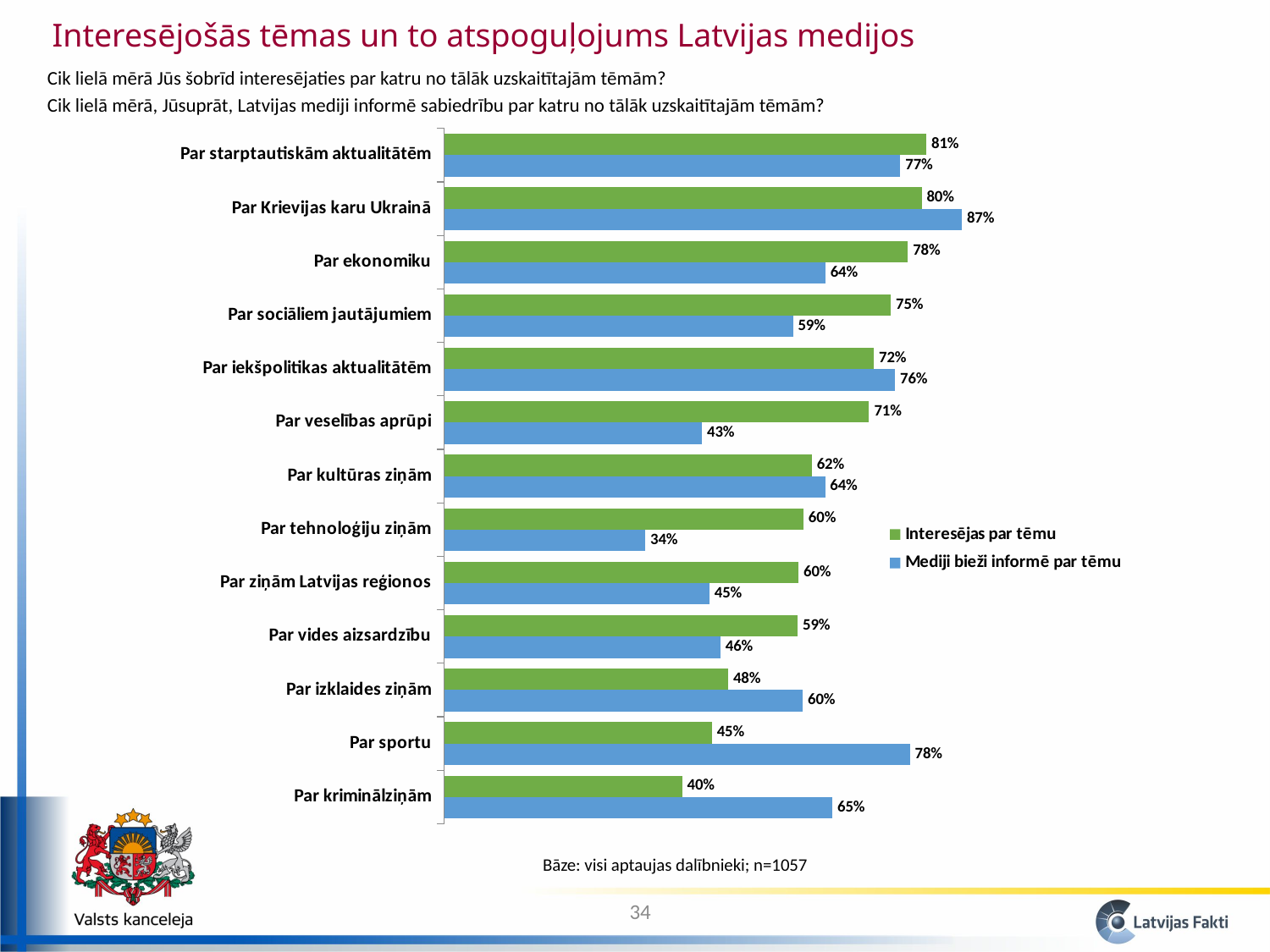
How many categories (topics) are shown in the chart? 13 Which category has the lowest value for "Mediji bieži informē par tēmu"? Par tehnoloģiju ziņām What is the value of "Interesējas par tēmu" for "Par ekonomiku"? 78% How many series does the legend list? 2 Which series is shown in green in the chart? Interesējas par tēmu What is the difference between "Interesējas par tēmu" and "Mediji bieži informē par tēmu" for "Par veselības aprūpi"? 28 percentage points What is the value of "Mediji bieži informē par tēmu" for "Par veselības aprūpi"? 43% Which category has the highest value for "Mediji bieži informē par tēmu"? Par Krievijas karu Ukrainā What is the value of "Mediji bieži informē par tēmu" for "Par sportu"? 78% For "Par kriminālziņām", which is larger: "Interesējas par tēmu" or "Mediji bieži informē par tēmu"? Mediji bieži informē par tēmu What kind of chart is shown on the slide? Bar chart Which category has the lowest value for "Interesējas par tēmu"? Par kriminālziņām